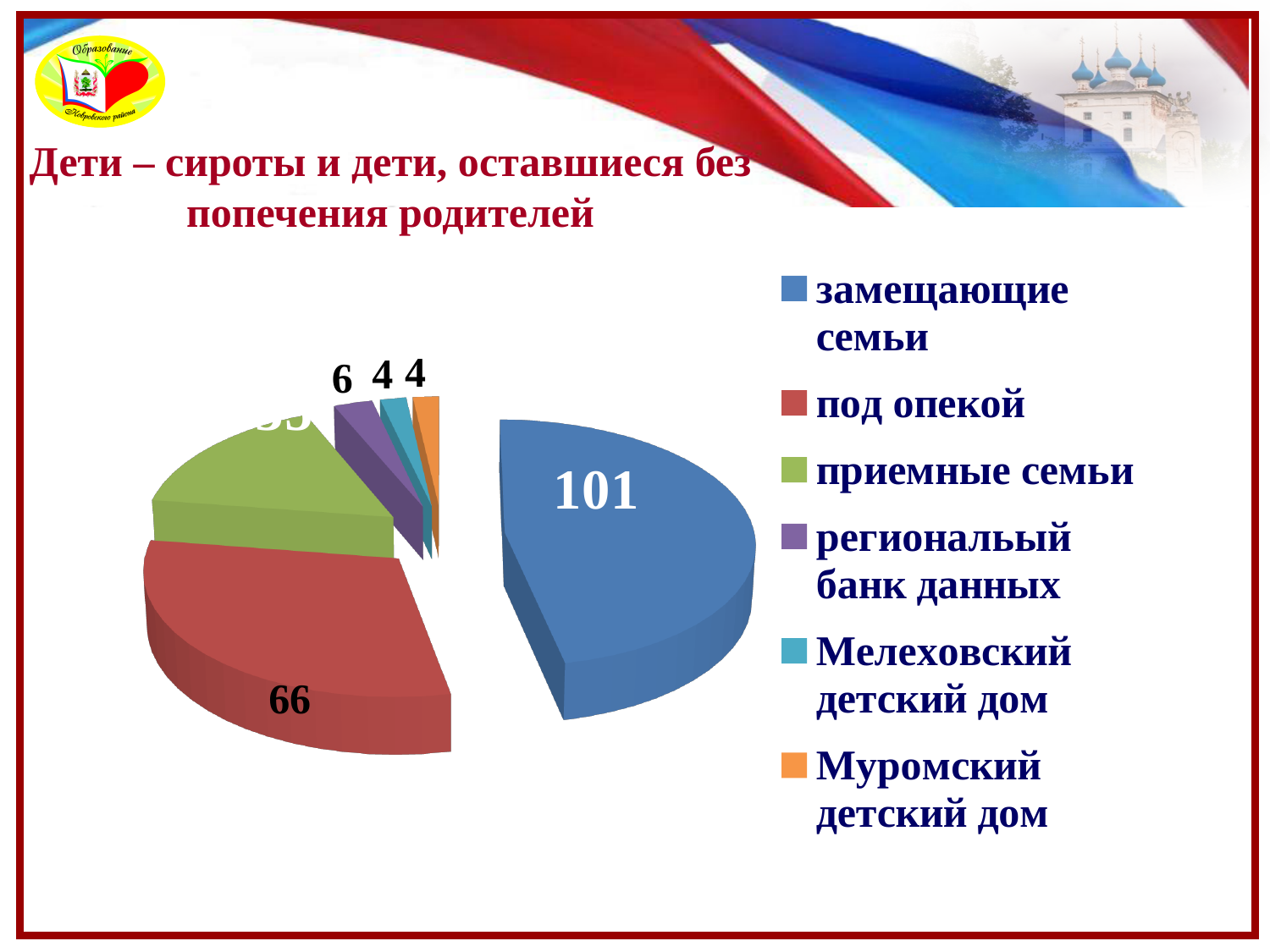
Which is larger, под опекой or региональный банк данных? под опекой What is the value for Мелеховский детский дом? 4 What is the difference between the values for замещающие семьи and под опекой? 35 What is the value for региональный банк данных? 6 What kind of chart is shown on the slide? pie chart How many categories does the pie chart have? 6 What is the value for под опекой? 66 What colour is the slice for замещающие семьи? blue What is the value for замещающие семьи? 101 Which category has the largest slice of the pie? замещающие семьи Which is larger, приемные семьи or Муромский детский дом? приемные семьи What is the value for Муромский детский дом? 4